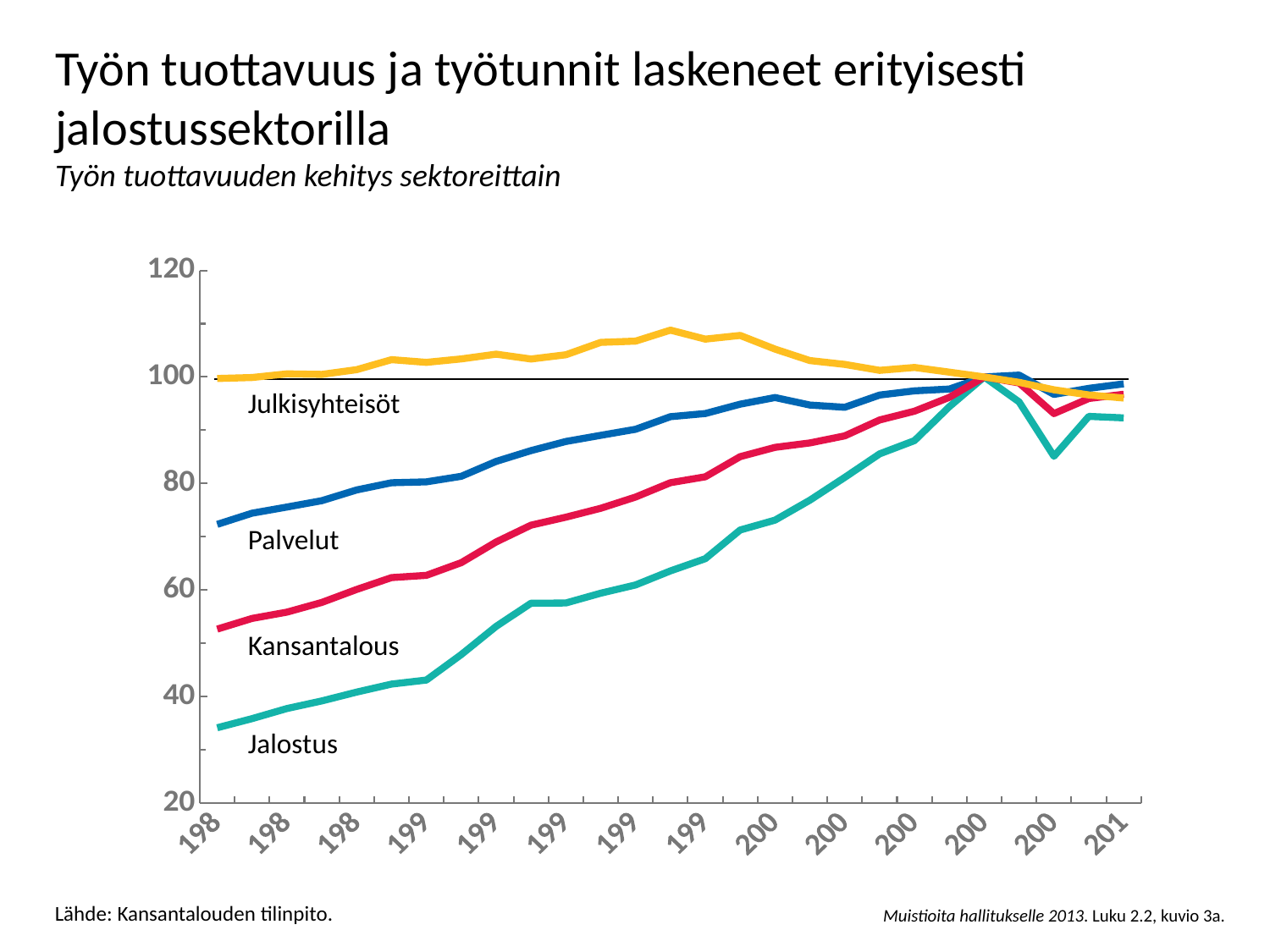
What kind of chart is shown on the slide? line chart How many series are plotted in the chart? 4 Is the highest point of the Julkisyhteisöt line greater or less than 100? greater Is the value of Palvelut at the left end of the chart greater or less than 70? greater Does the Jalostus line generally rise or fall from left to right across the chart? rise Which series has the highest value at the left end of the chart? Julkisyhteisöt What is the lowest value shown on the vertical axis? 20 Which series has the lowest value at the left end of the chart? Jalostus What is the subtitle of the chart shown below the slide title? Työn tuottavuuden kehitys sektoreittain Is the value of Kansantalous at the left end of the chart greater or less than 60? less At the left end of the chart, which is larger: Palvelut or Kansantalous? Palvelut